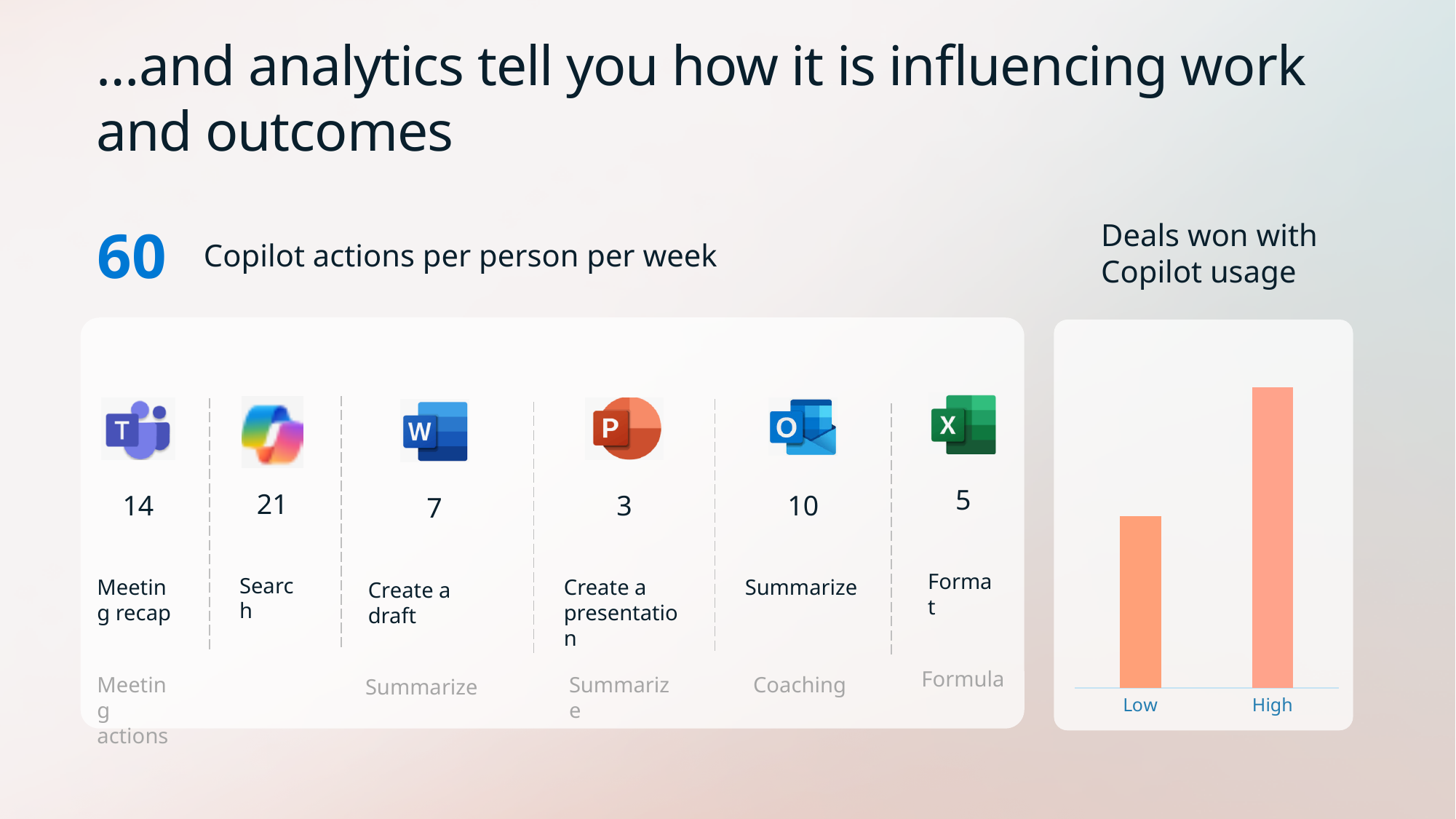
What kind of chart is shown under the title "Deals won with Copilot usage"? bar chart What is the title of the bar chart on the right side of the slide? Deals won with Copilot usage In the "Deals won with Copilot usage" chart, do the bars rise or fall from Low to High? rise What are the two category labels on the x axis of the "Deals won with Copilot usage" chart? Low and High In the "Deals won with Copilot usage" chart, which category has the highest bar? High In the "Deals won with Copilot usage" chart, is the bar for High larger or smaller than the bar for Low? larger In the "Deals won with Copilot usage" chart, which category has the lowest bar? Low How many bars does the "Deals won with Copilot usage" chart have? 2